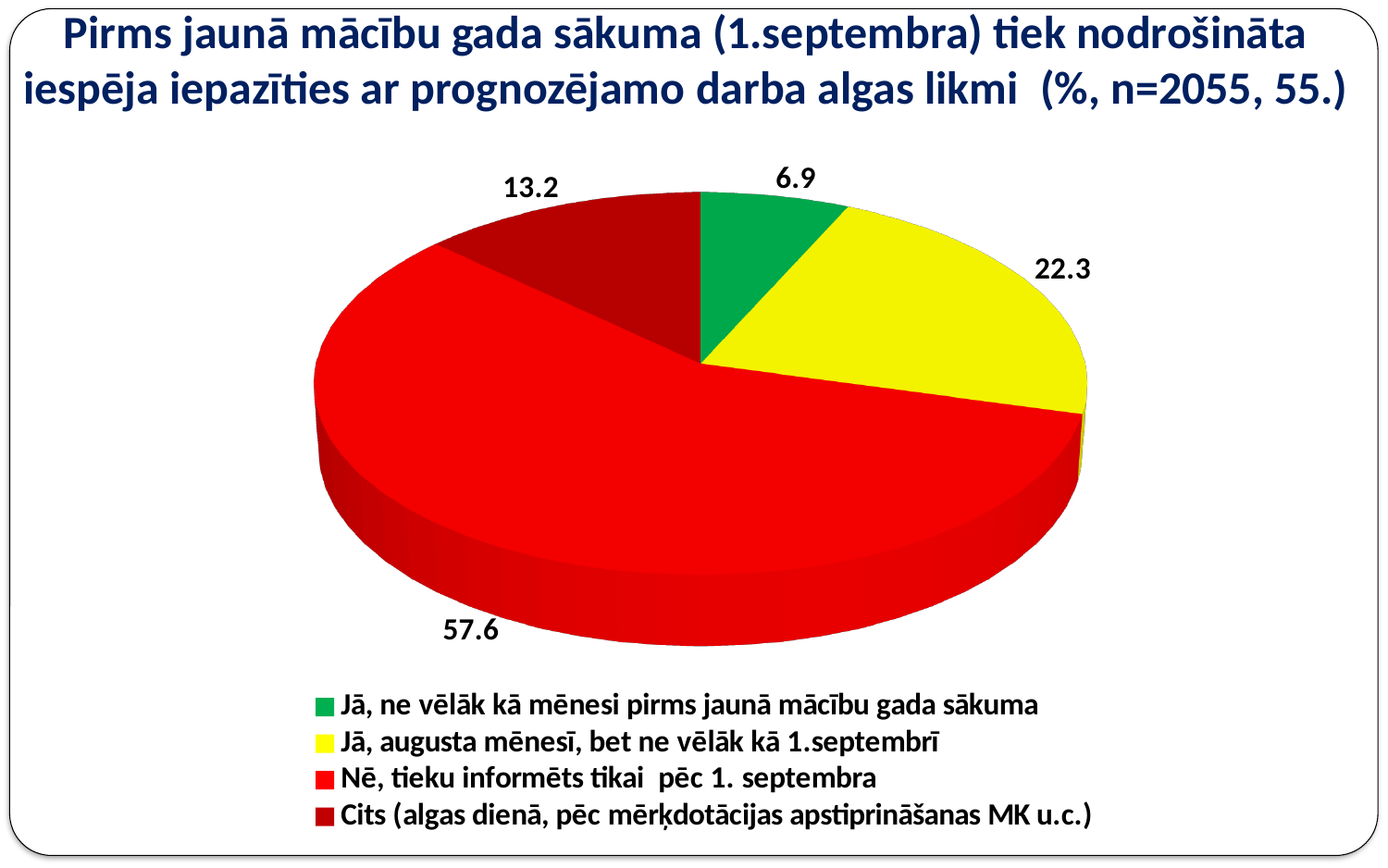
What is the value for "Nē, tieku informēts tikai pēc 1. septembra"? 57.6 What is the value for "Cits (algas dienā, pēc mērķdotācijas apstiprināšanas MK u.c.)"? 13.2 Which category has the largest share of the pie? Nē, tieku informēts tikai pēc 1. septembra What is the sample size (n) stated in the chart title? 2055 What kind of chart is shown on the slide? pie chart Which is larger: the value for "Cits (algas dienā, pēc mērķdotācijas apstiprināšanas MK u.c.)" or the value for "Jā, ne vēlāk kā mēnesi pirms jaunā mācību gada sākuma"? Cits (algas dienā, pēc mērķdotācijas apstiprināšanas MK u.c.) What is the value for "Jā, ne vēlāk kā mēnesi pirms jaunā mācību gada sākuma"? 6.9 How many categories does the pie chart have? 4 What is the value for "Jā, augusta mēnesī, bet ne vēlāk kā 1.septembrī"? 22.3 What is the difference between the values for "Jā, augusta mēnesī, bet ne vēlāk kā 1.septembrī" and "Cits (algas dienā, pēc mērķdotācijas apstiprināšanas MK u.c.)"? 9.1 What colour is the slice for "Jā, augusta mēnesī, bet ne vēlāk kā 1.septembrī"? yellow Which category has the smallest share of the pie? Jā, ne vēlāk kā mēnesi pirms jaunā mācību gada sākuma